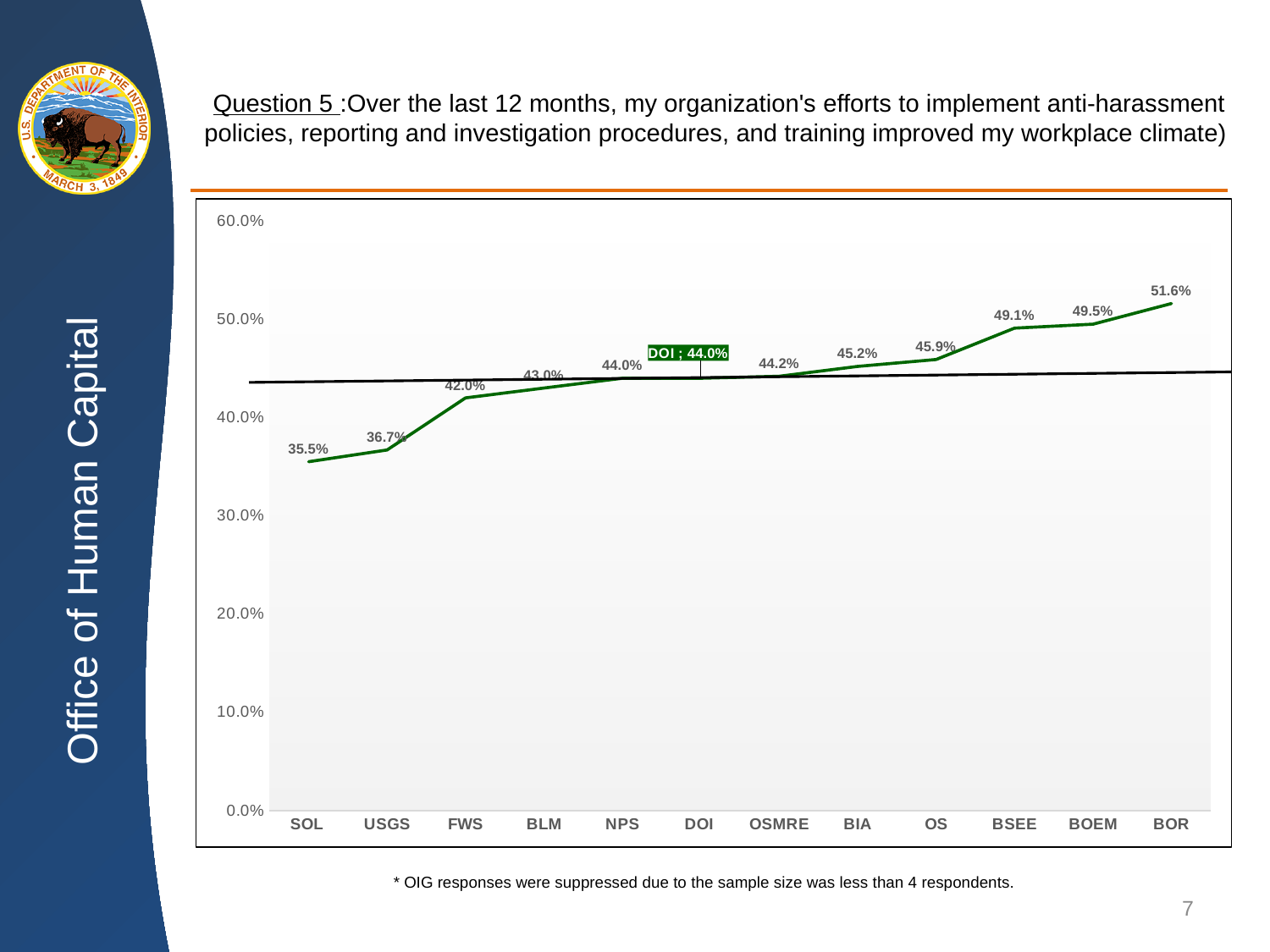
What is the difference between the values for BOR and SOL? 16.1% Which is larger, the value for FWS or the value for OS? OS How many categories are shown on the x axis? 12 Is the value for USGS greater or less than 40.0%? less What kind of chart is this? line chart Which category has the lowest value? SOL What is the value for BSEE? 49.1% What is the value for SOL? 35.5% Which category has the highest value? BOR What is the difference between the values for BOEM and BSEE? 0.4% What is the value for OSMRE? 44.2% Do the values rise or fall from left to right along the x axis? rise